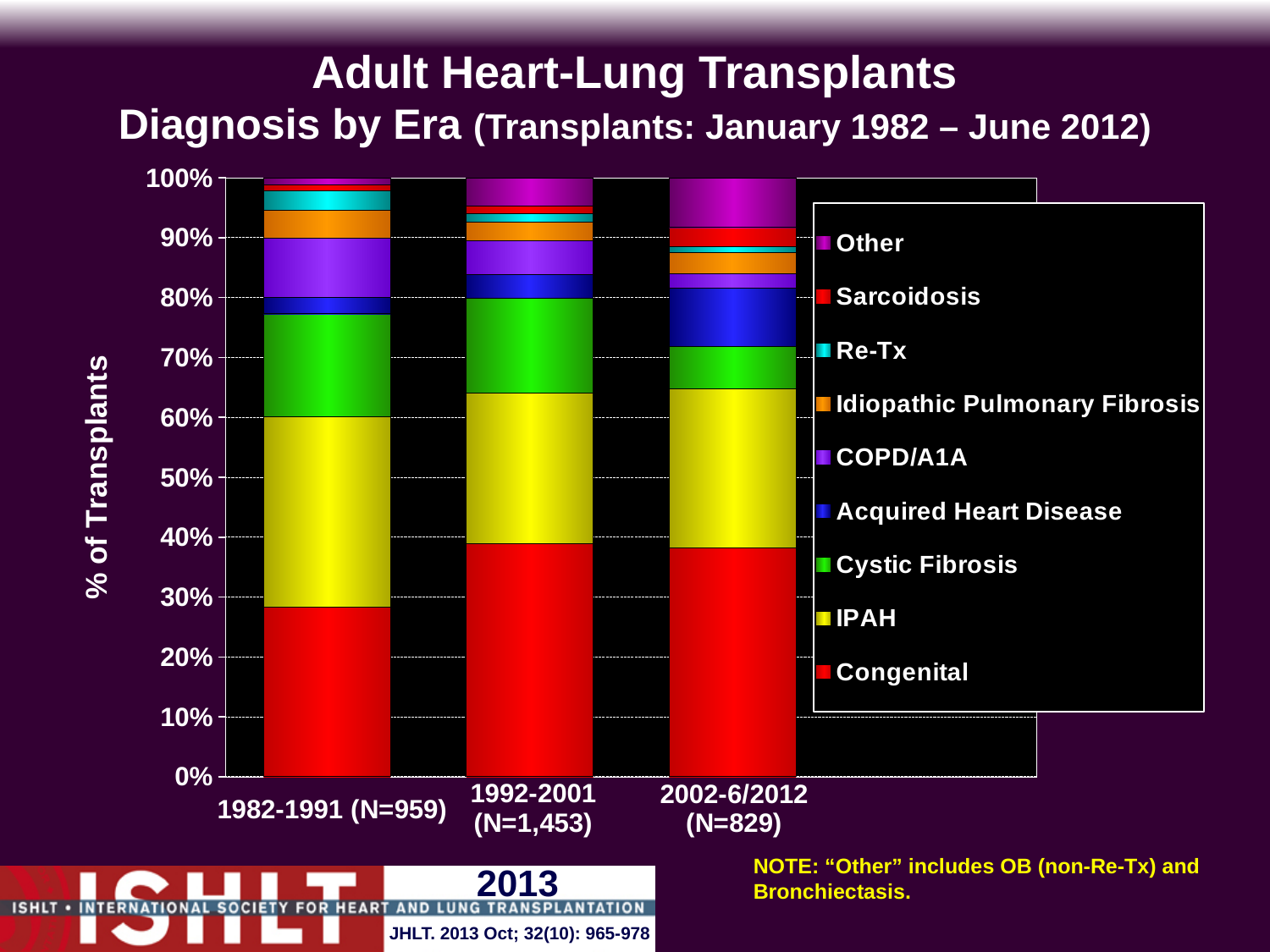
In which era is the Acquired Heart Disease segment largest? 2002-6/2012 Does the Cystic Fibrosis share rise or fall from the 1982-1991 era to the 2002-6/2012 era? fall Which is larger, the Congenital share in 1982-1991 or in 1992-2001? 1992-2001 Is the Congenital share for 1992-2001 greater or less than 30%? greater How many diagnosis series does the legend list? 9 In which era is the Other segment largest? 2002-6/2012 What kind of chart is shown on the slide? Stacked bar chart What is the N shown for the 1992-2001 era? N=1,453 How many eras (categories) are plotted on the x axis? 3 What does each stacked bar total? 100% Is the Congenital share for 1982-1991 greater or less than 30%? less In which era is the Cystic Fibrosis segment smallest? 2002-6/2012